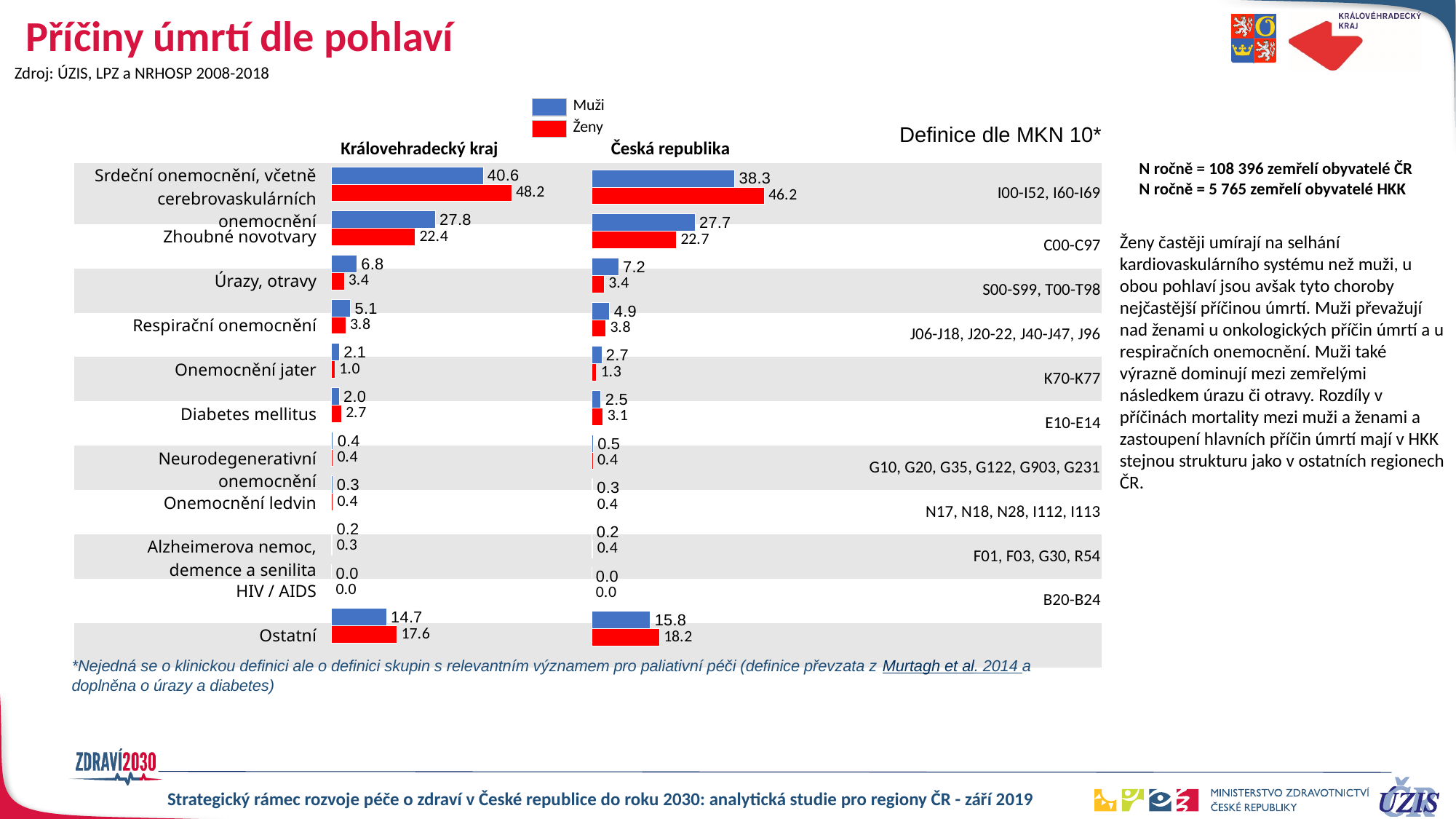
In the Královehradecký kraj chart, what is the value for Muži for Ostatní? 14.7 In the Královehradecký kraj chart, what is the difference between the Muži and Ženy values for Úrazy, otravy? 3.4 In the Česká republika chart, which is larger for Onemocnění jater: the Muži value or the Ženy value? Muži What kind of chart is used for the Česká republika data? Bar chart In the Česká republika chart, what is the value for Muži for Srdeční onemocnění, včetně cerebrovaskulárních onemocnění? 38.3 In the Královehradecký kraj chart, what is the value for Ženy for Zhoubné novotvary? 22.4 In the Česká republika chart, what is the value for Ženy for Diabetes mellitus? 3.1 In the Česká republika chart, what is the difference between the Ženy and Muži values for Srdeční onemocnění, včetně cerebrovaskulárních onemocnění? 7.9 In the Královehradecký kraj chart, which category has the highest value for Ženy? Srdeční onemocnění, včetně cerebrovaskulárních onemocnění How many categories are shown in the Královehradecký kraj chart? 11 Which colour represents Ženy in the legend? Red How many series does the legend list? 2